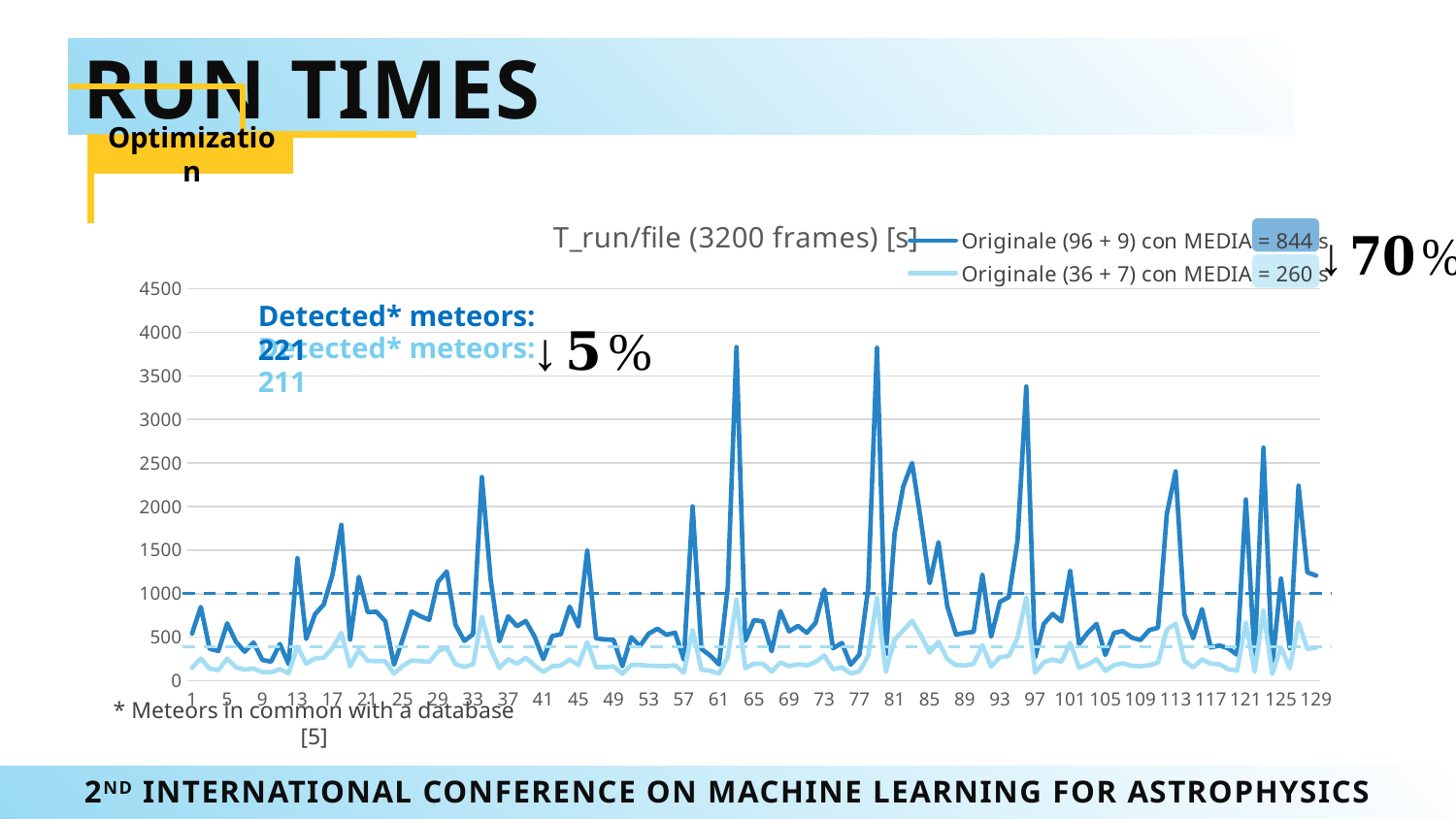
According to the legend, what is the MEDIA value for the Originale (96 + 9) series? 844 s How many series does the chart legend list? 2 Which series has the lower MEDIA value according to the legend, Originale (96 + 9) or Originale (36 + 7)? Originale (36 + 7) Is the value of the Originale (36 + 7) series at file 63 greater or less than 1000? less At file 79, which series has the higher value, Originale (96 + 9) or Originale (36 + 7)? Originale (96 + 9) What is the maximum value shown on the y axis? 4500 Is the highest value of the Originale (36 + 7) series greater or less than 1500? less What is the title of the chart? T_run/file (3200 frames) [s] What type of chart is shown on the slide? line chart How many files (x-axis points) are plotted in the chart? 129 Is the value of the Originale (96 + 9) series at file 63 greater or less than 3500? greater